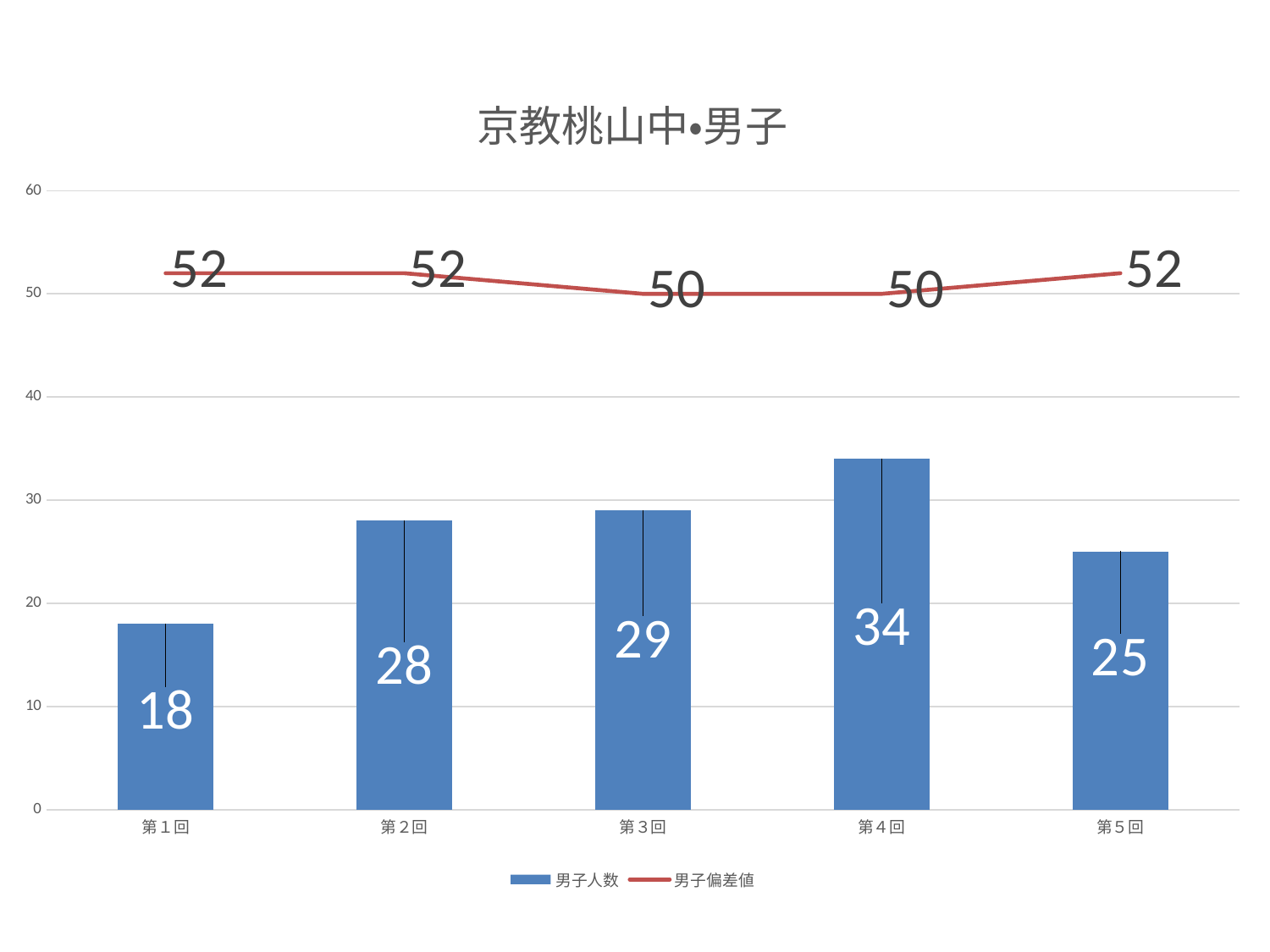
Which has a larger 男子人数, 第２回 or 第５回? 第２回 What is the difference in 男子人数 between 第４回 and 第１回? 16 Which category has the lowest 男子人数? 第１回 What is the 男子人数 value for 第４回? 34 What kind of chart is used for the 男子人数 series? bar chart How many series does the legend list? 2 What is the 男子偏差値 value for 第３回? 50 Which category has the highest 男子人数? 第４回 What is the 男子人数 value for 第１回? 18 How many categories are shown on the x axis? 5 Does the 男子人数 rise or fall from 第１回 to 第４回? rise What is the title of the chart? 京教桃山中•男子